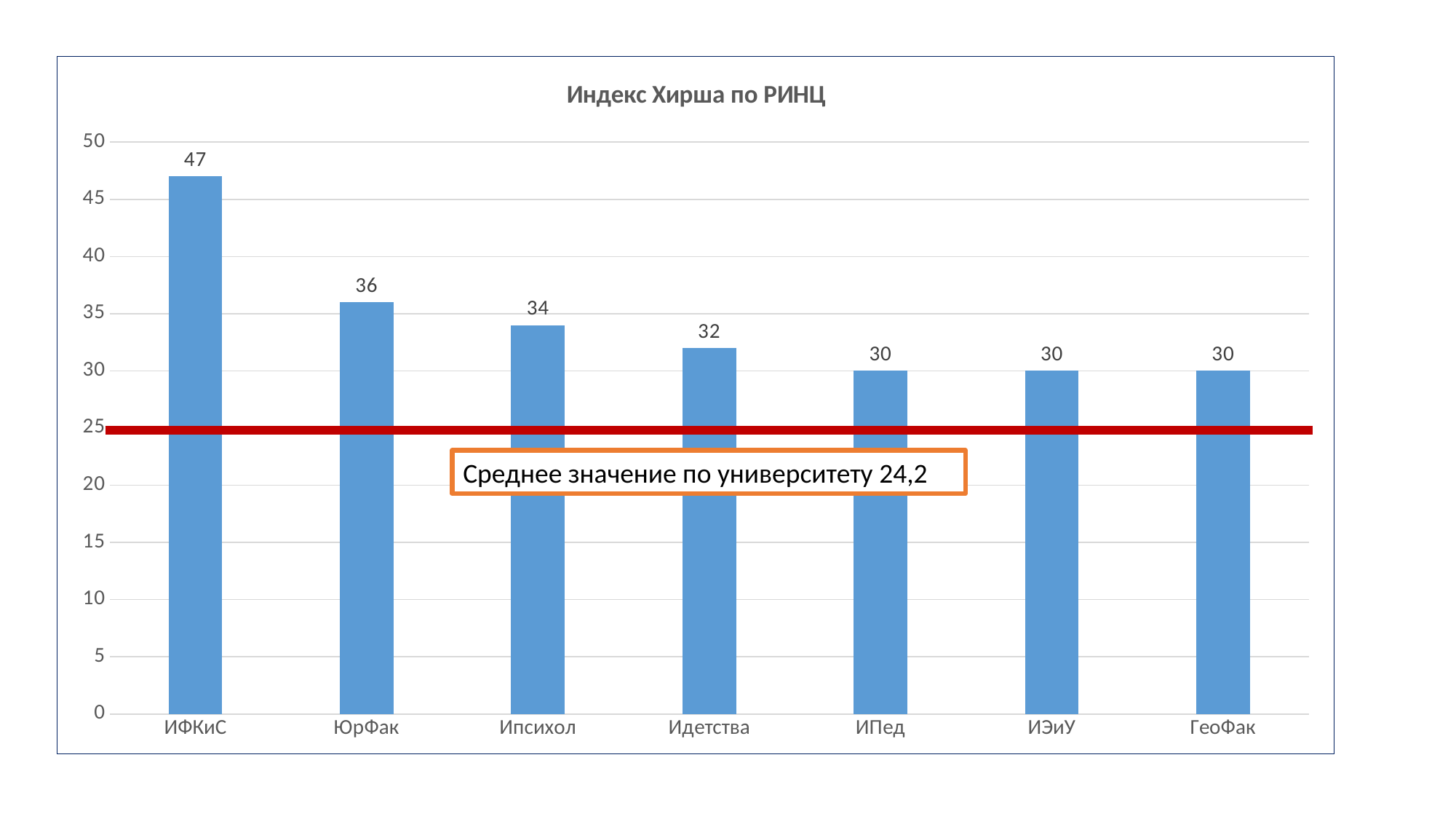
What is the value for Идетства? 32 Is the value for ИПед greater or less than 25? greater What kind of chart is this? bar chart What is the difference between the values for Ипсихол and ГеоФак? 4 What average value for the university is stated in the box on the chart? 24,2 Which category has the highest value? ИФКиС What is the title of the chart? Индекс Хирша по РИНЦ How many categories are shown on the x axis? 7 What is the value for ИФКиС? 47 What is the value for ЮрФак? 36 What is the difference between the values for ИФКиС and ЮрФак? 11 Which is larger, the value for ЮрФак or the value for Ипсихол? ЮрФак